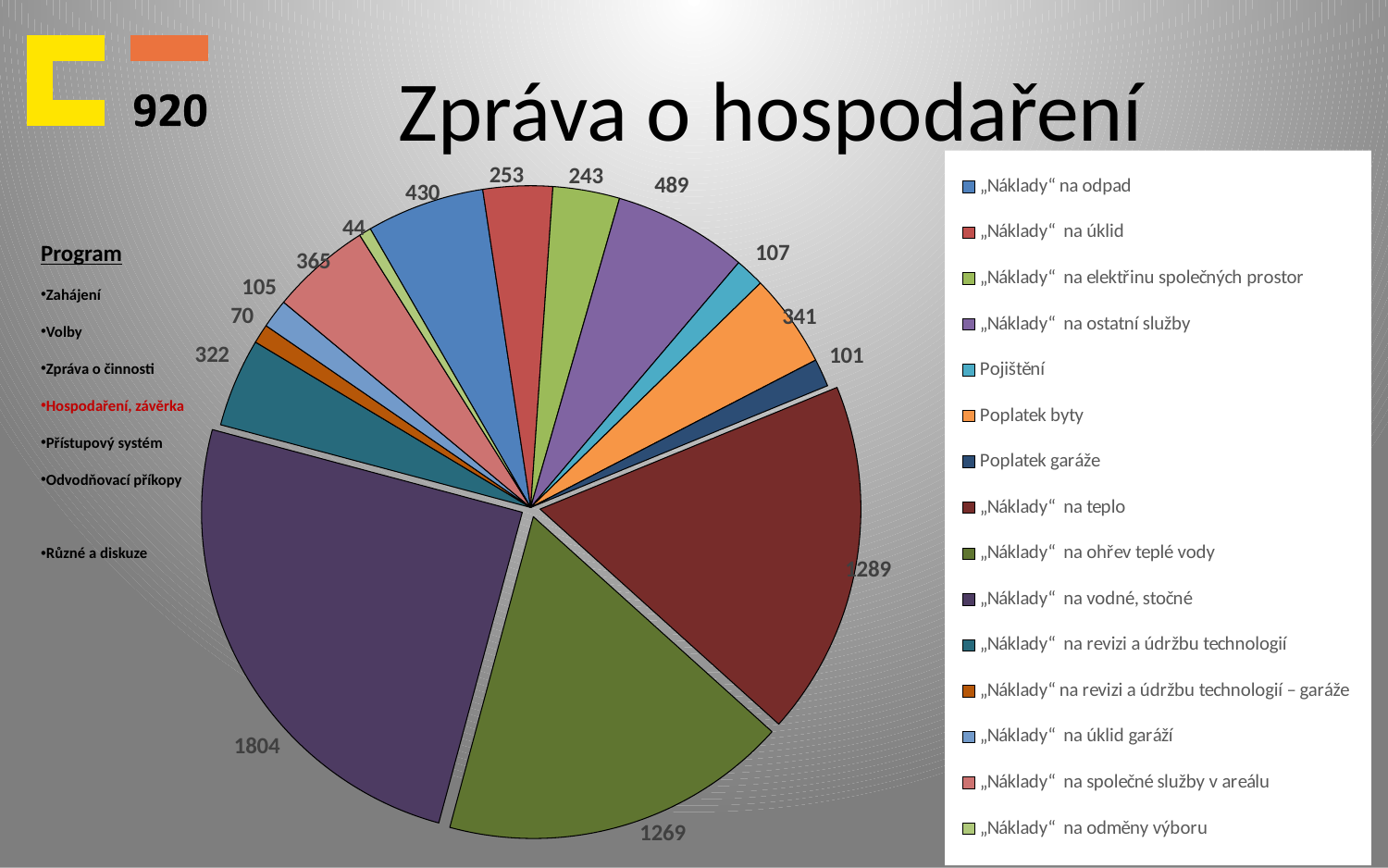
What type of chart is shown on the slide? pie chart What is the difference between the values for „Náklady“ na teplo and „Náklady“ na ohřev teplé vody? 20 Which is larger, the value for „Náklady“ na ostatní služby or „Náklady“ na odpad? „Náklady“ na ostatní služby What is the value for Poplatek byty? 341 How many categories does the legend list? 15 Which category has the largest slice of the pie? „Náklady“ na vodné, stočné What is the value for „Náklady“ na odpad? 430 What is the title of the slide containing the chart? Zpráva o hospodaření Which category has the smallest slice of the pie? „Náklady“ na odměny výboru What is the value for „Náklady“ na vodné, stočné? 1804 What is the value for „Náklady“ na teplo? 1289 What is the value for Pojištění? 107